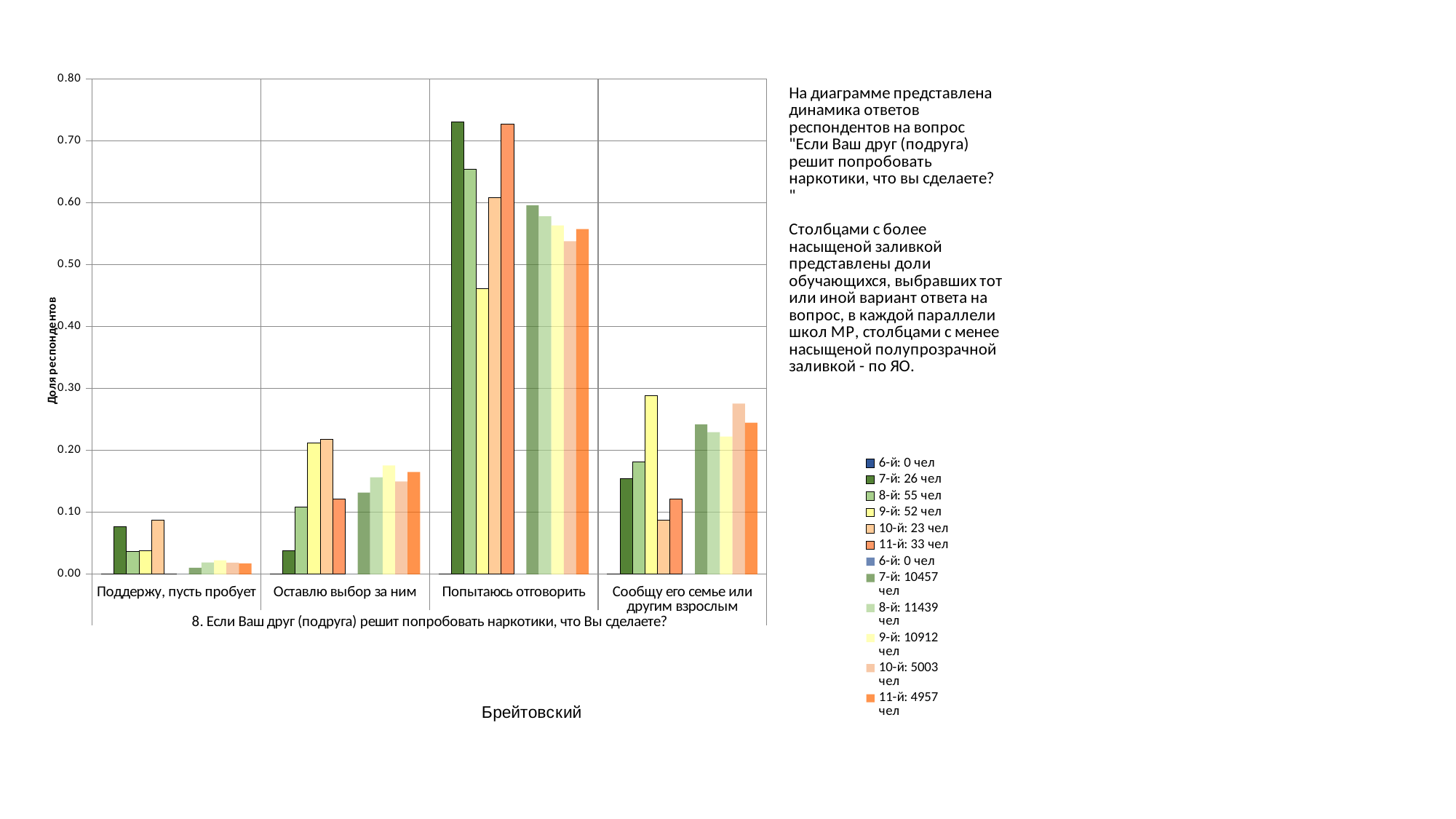
Is the value for the series "9-й: 52 чел" in the category "Попытаюсь отговорить" greater or less than 0.50? less How many answer categories are shown along the x axis of the chart? 4 Is the value for the series "7-й: 26 чел" in the category "Попытаюсь отговорить" greater or less than 0.70? greater How many series does the chart's legend list? 12 In the category "Попытаюсь отговорить", which is larger: the value for "7-й: 26 чел" or for "9-й: 52 чел"? 7-й: 26 чел In the category "Сообщу его семье или другим взрослым", which is larger: the value for "9-й: 52 чел" or for "10-й: 23 чел"? 9-й: 52 чел What is the label of the vertical axis of the chart? Доля респондентов Is the value for the series "10-й: 23 чел" in the category "Оставлю выбор за ним" greater or less than 0.30? less What kind of chart is shown on the slide? bar chart Which answer category has the tallest bars in the chart? Попытаюсь отговорить Which answer category has the lowest bars in the chart? Поддержу, пусть пробует